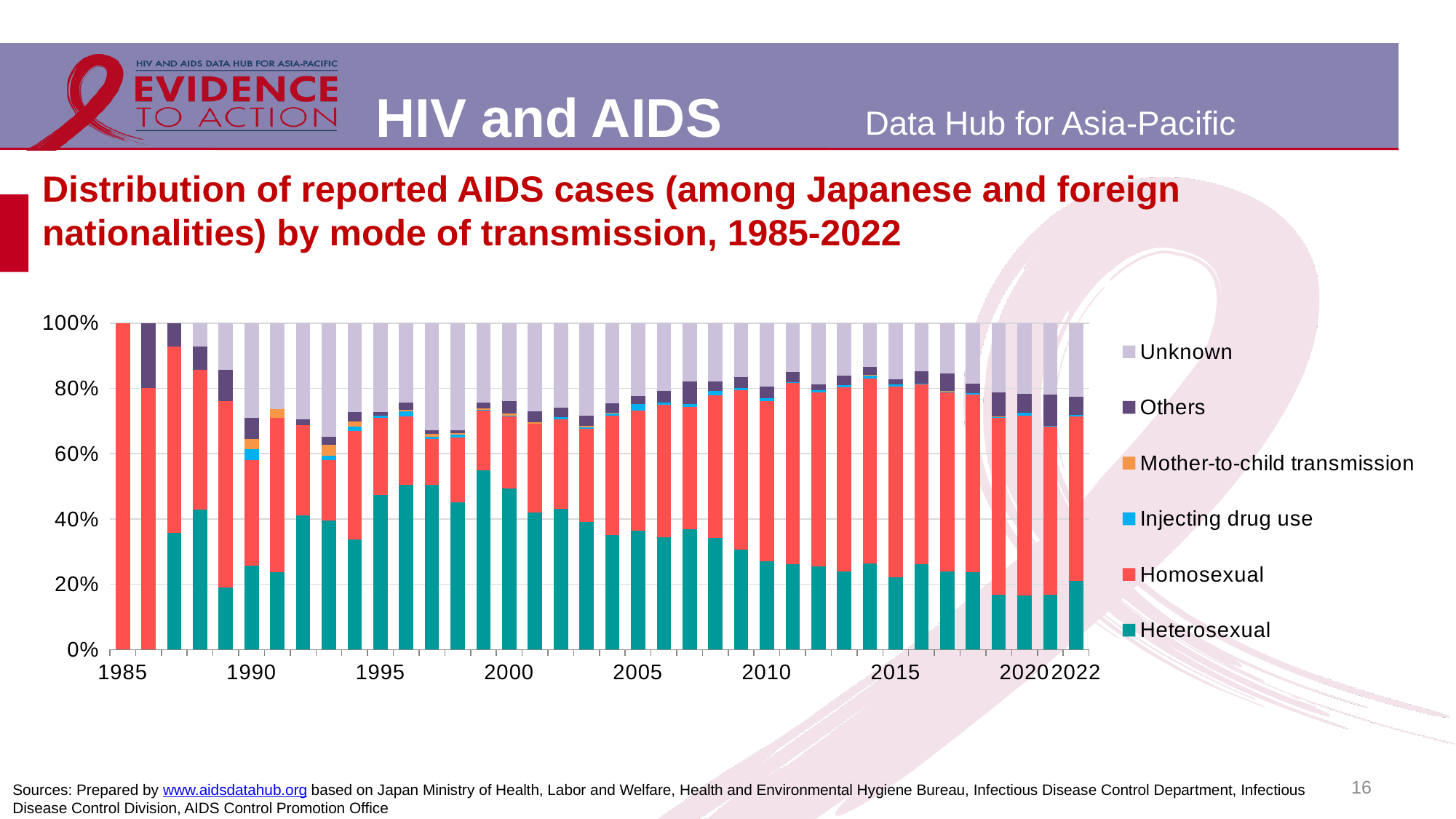
Which year has the highest Heterosexual share? 1999 Is the Heterosexual share in 2020 greater or less than 20%? less What kind of chart is shown on the slide? Stacked bar chart Is the Homosexual share in 1985 greater or less than 80%? greater Is the Heterosexual share in 1999 greater or less than 40%? greater From 1999 to 2022, does the Heterosexual share generally rise or fall? fall How many years (bars) are plotted in the chart? 38 Which is larger, the Heterosexual share in 1999 or in 2020? 1999 How many series does the legend list? 6 What is the first year shown on the x axis? 1985 Which series is listed at the bottom of the legend? Heterosexual